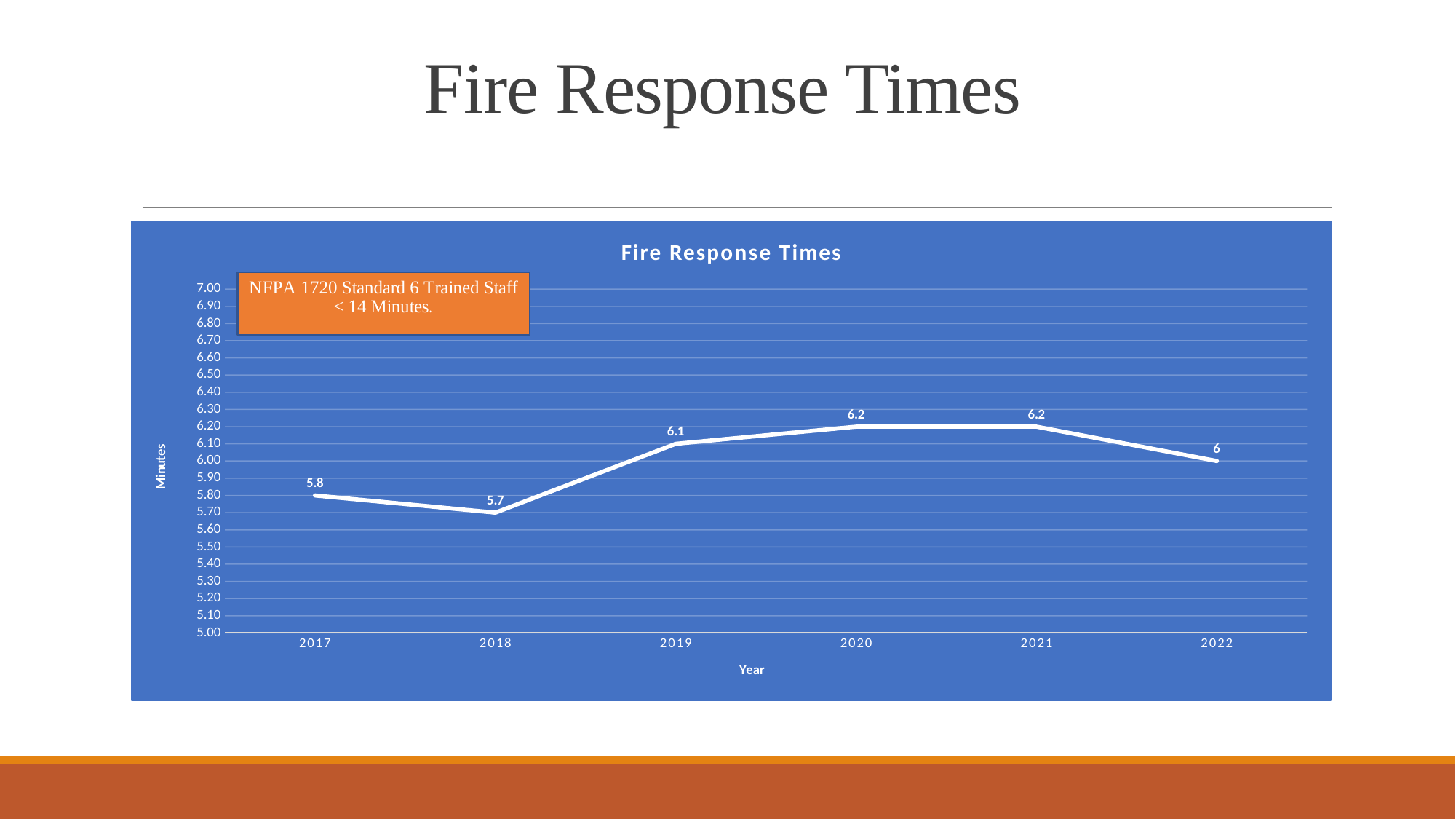
What is the fire response time for 2022? 6 How many years are plotted on the chart? 6 Which is larger, the fire response time for 2017 or for 2022? 2022 Is the fire response time for 2020 greater or less than 6.00? greater What kind of chart is shown on the slide? line chart Which year has the lowest fire response time? 2018 What is the fire response time for 2018? 5.7 Does the fire response time rise or fall from 2018 to 2020? rise What is the fire response time for 2017? 5.8 What is the difference between the fire response times for 2019 and 2018? 0.4 What is the title of the chart? Fire Response Times What is the label on the vertical axis of the chart? Minutes